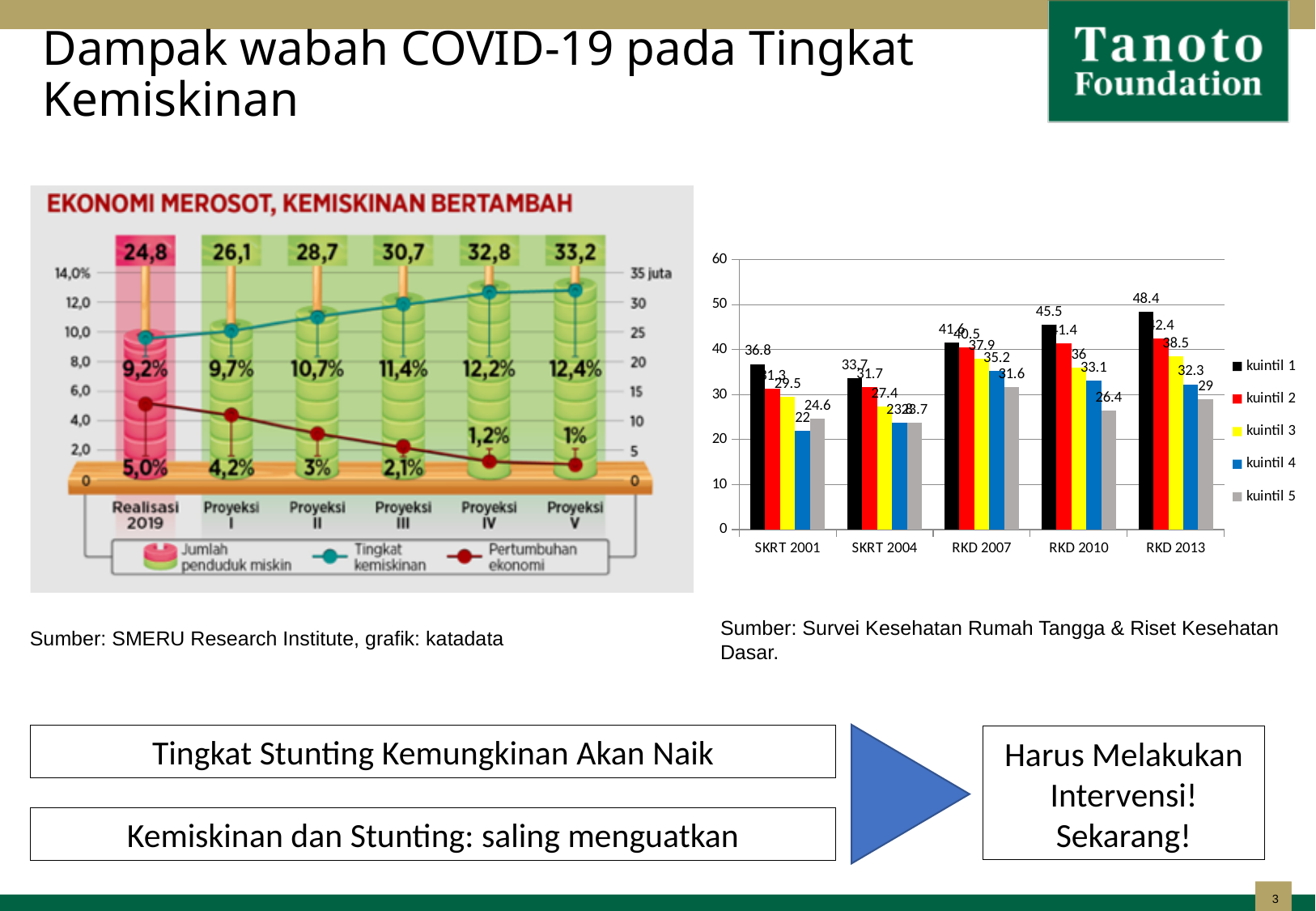
In the left-hand chart 'EKONOMI MEROSOT, KEMISKINAN BERTAMBAH', what is the Pertumbuhan ekonomi for Realisasi 2019? 5,0% In the left-hand chart 'EKONOMI MEROSOT, KEMISKINAN BERTAMBAH', what is the Tingkat kemiskinan for Proyeksi V? 12,4% In the left-hand chart 'EKONOMI MEROSOT, KEMISKINAN BERTAMBAH', does Pertumbuhan ekonomi rise or fall from Realisasi 2019 to Proyeksi V? Fall In the right-hand bar chart, which survey has the highest value for kuintil 1? RKD 2013 In the right-hand bar chart, is the value for kuintil 5 in RKD 2010 greater or less than 30? less In the right-hand bar chart, what is the value for kuintil 5 in SKRT 2001? 24.6 In the right-hand bar chart, what is the value for kuintil 1 in RKD 2013? 48.4 In the right-hand bar chart, what is the difference between kuintil 1 in RKD 2013 and kuintil 1 in SKRT 2001? 11.6 In the right-hand bar chart, how many survey categories are shown on the x axis? 5 What kind of chart is the right-hand chart? Bar chart In the left-hand chart 'EKONOMI MEROSOT, KEMISKINAN BERTAMBAH', what is the Jumlah penduduk miskin for Proyeksi III? 30,7 In the right-hand bar chart, how many series does the legend list? 5